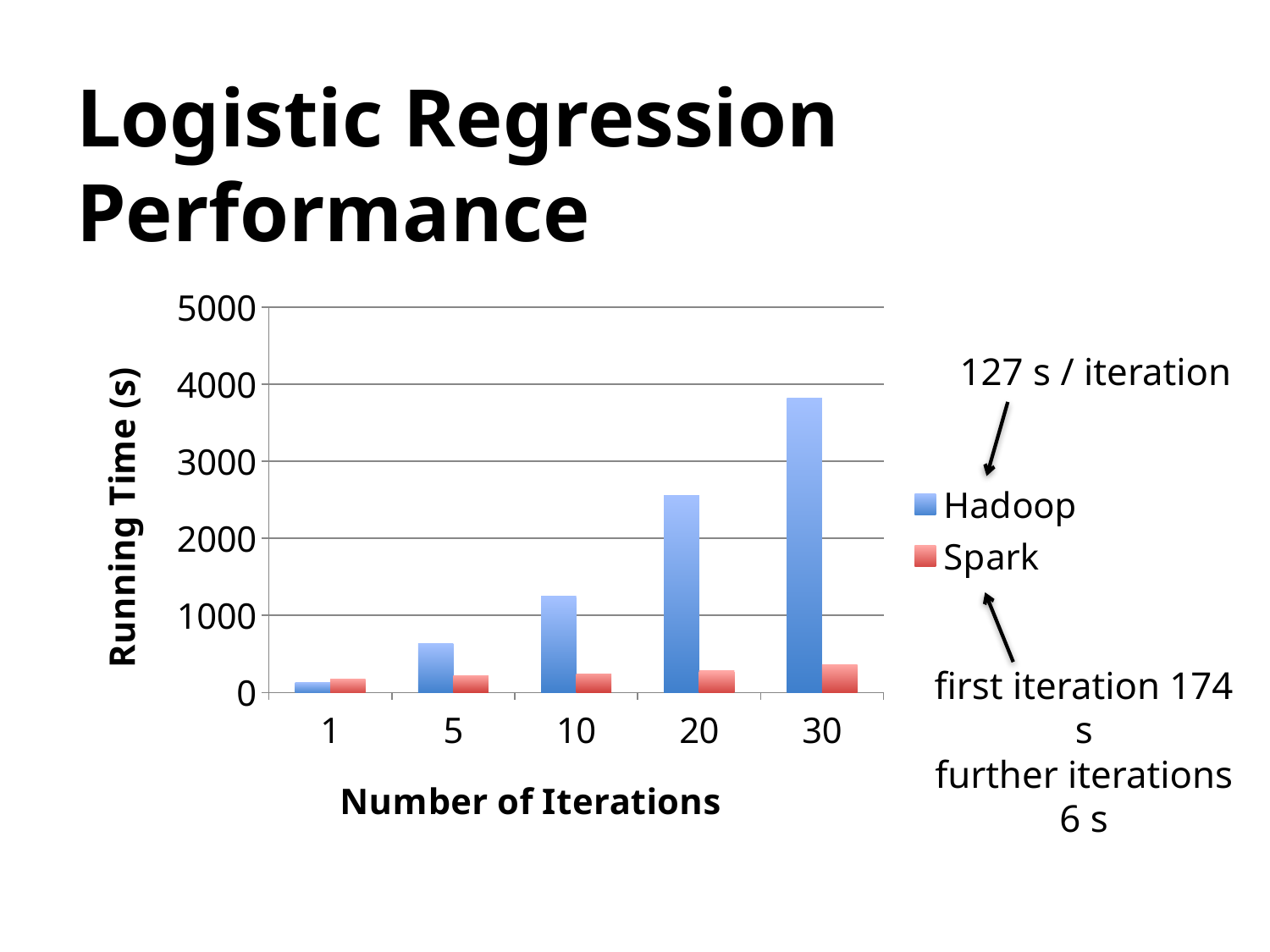
What is the label of the y axis? Running Time (s) How many iteration counts are shown on the x axis? 5 What kind of chart is shown on the slide? bar chart At which number of iterations is the Hadoop running time highest? 30 At 30 iterations, which has the larger running time, Hadoop or Spark? Hadoop Is the Hadoop running time at 20 iterations greater or less than 3000? less Is the Spark running time at 30 iterations greater or less than 1000? less At which number of iterations is the Hadoop running time lowest? 1 How many series does the legend list? 2 Does the Hadoop running time rise or fall as the number of iterations increases? rise Is the Hadoop running time at 5 iterations greater or less than 1000? less